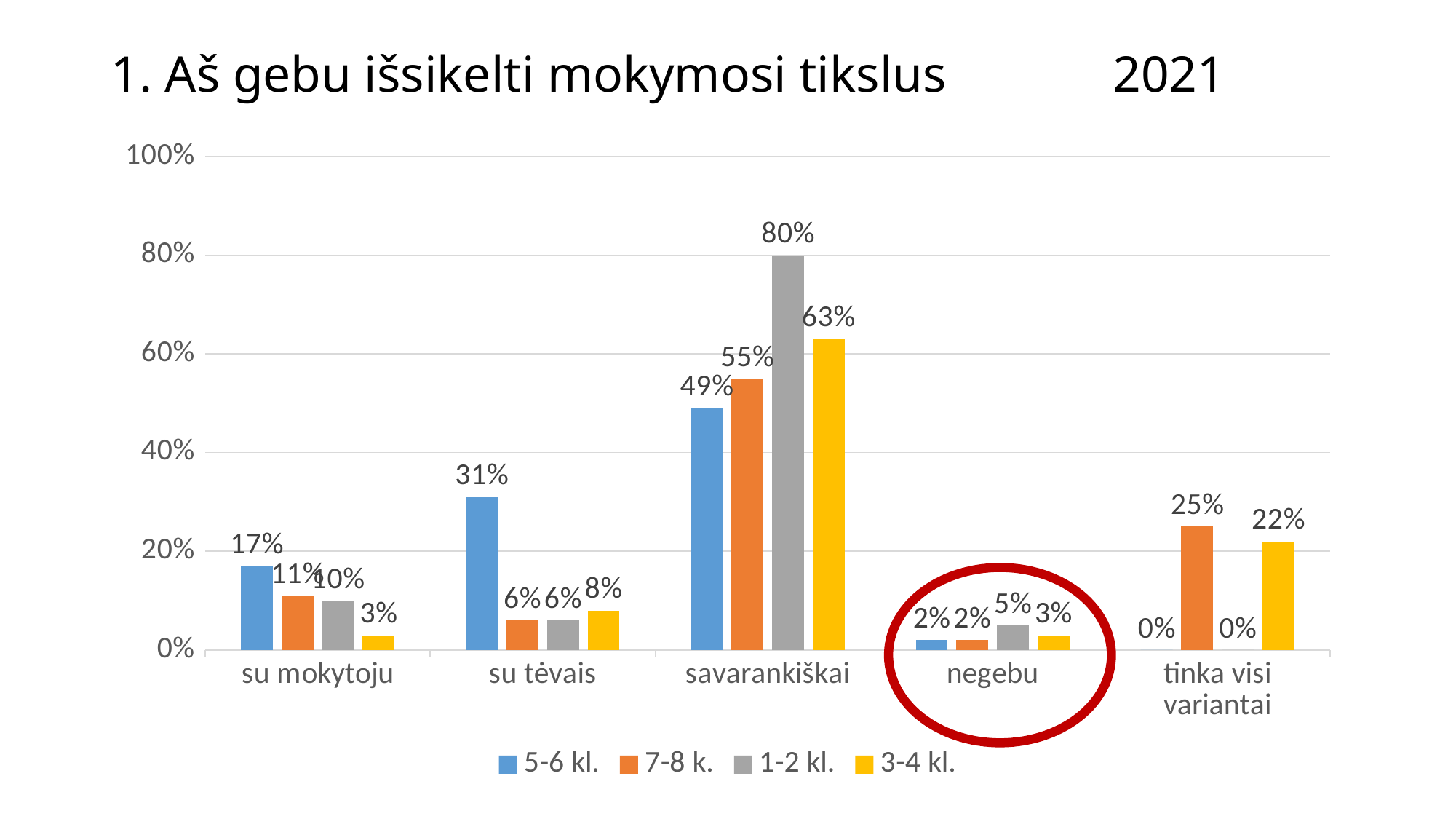
How many series does the legend list? 4 What is the value for 3-4 kl. in the su mokytoju category? 3% Which series has the highest value in the savarankiškai category? 1-2 kl. What is the value for 7-8 k. in the tinka visi variantai category? 25% What is the difference between the 1-2 kl. and 3-4 kl. values in the savarankiškai category? 17% Which category on the chart is circled in red? negebu What kind of chart is shown on the slide? bar chart Which series has the lowest value in the su mokytoju category? 3-4 kl. What is the value for 1-2 kl. in the savarankiškai category? 80% What is the value for 5-6 kl. in the su tėvais category? 31% How many categories are shown on the x axis? 5 Which is larger in the tinka visi variantai category: the 7-8 k. value or the 3-4 kl. value? 7-8 k.